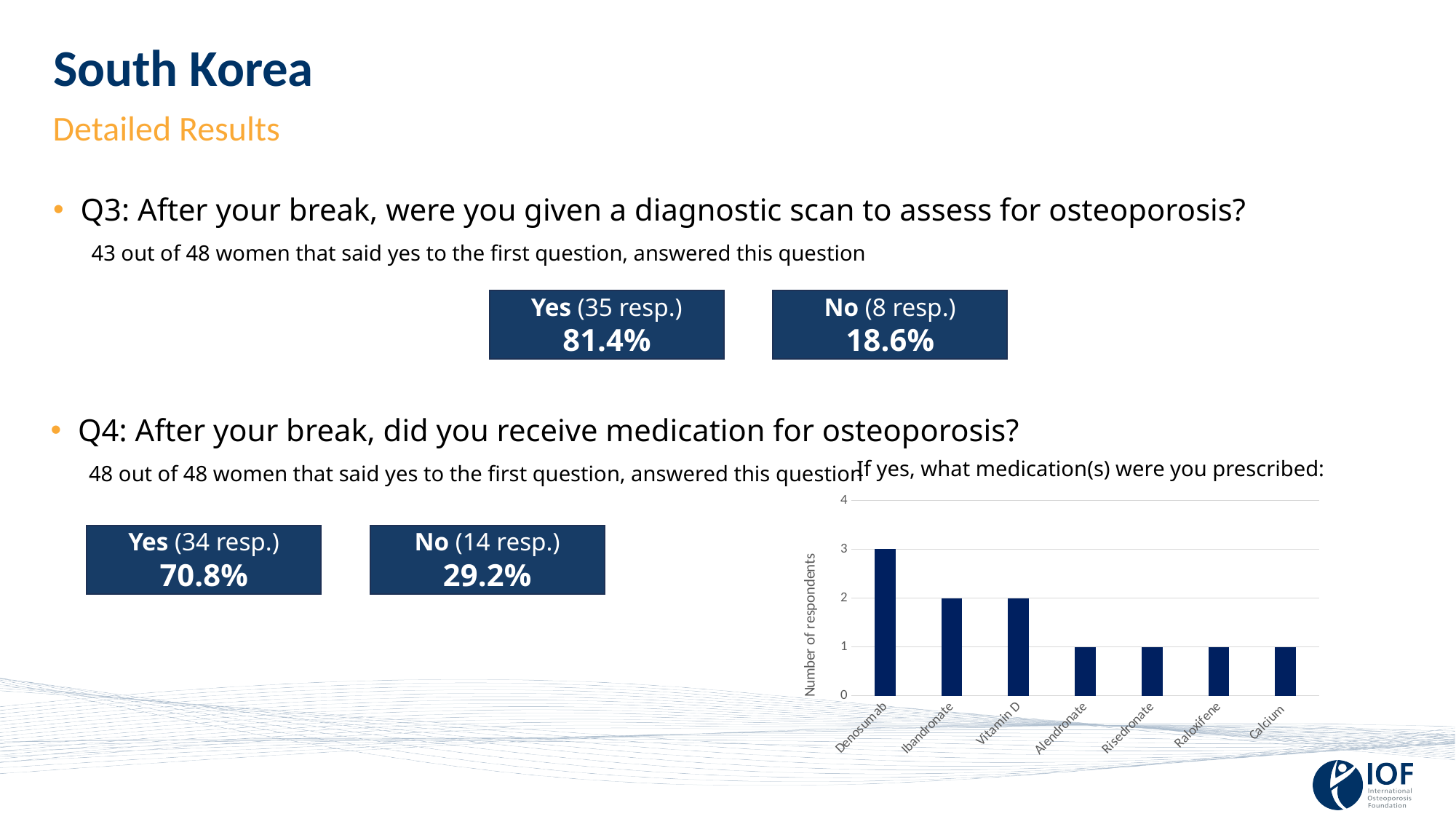
What is the label on the vertical axis of the chart? Number of respondents How many respondents were prescribed Denosumab? 3 How many medication categories are shown on the chart? 7 How many respondents were prescribed Calcium? 1 Do the values generally rise or fall from left to right across the medications? fall What is the title of the chart? If yes, what medication(s) were you prescribed: How many respondents were prescribed Vitamin D? 2 What is the difference in number of respondents between Denosumab and Alendronate? 2 What type of chart is shown on the slide? bar chart Which has more respondents, Ibandronate or Risedronate? Ibandronate Which medication has the highest number of respondents? Denosumab How many respondents were prescribed Ibandronate? 2